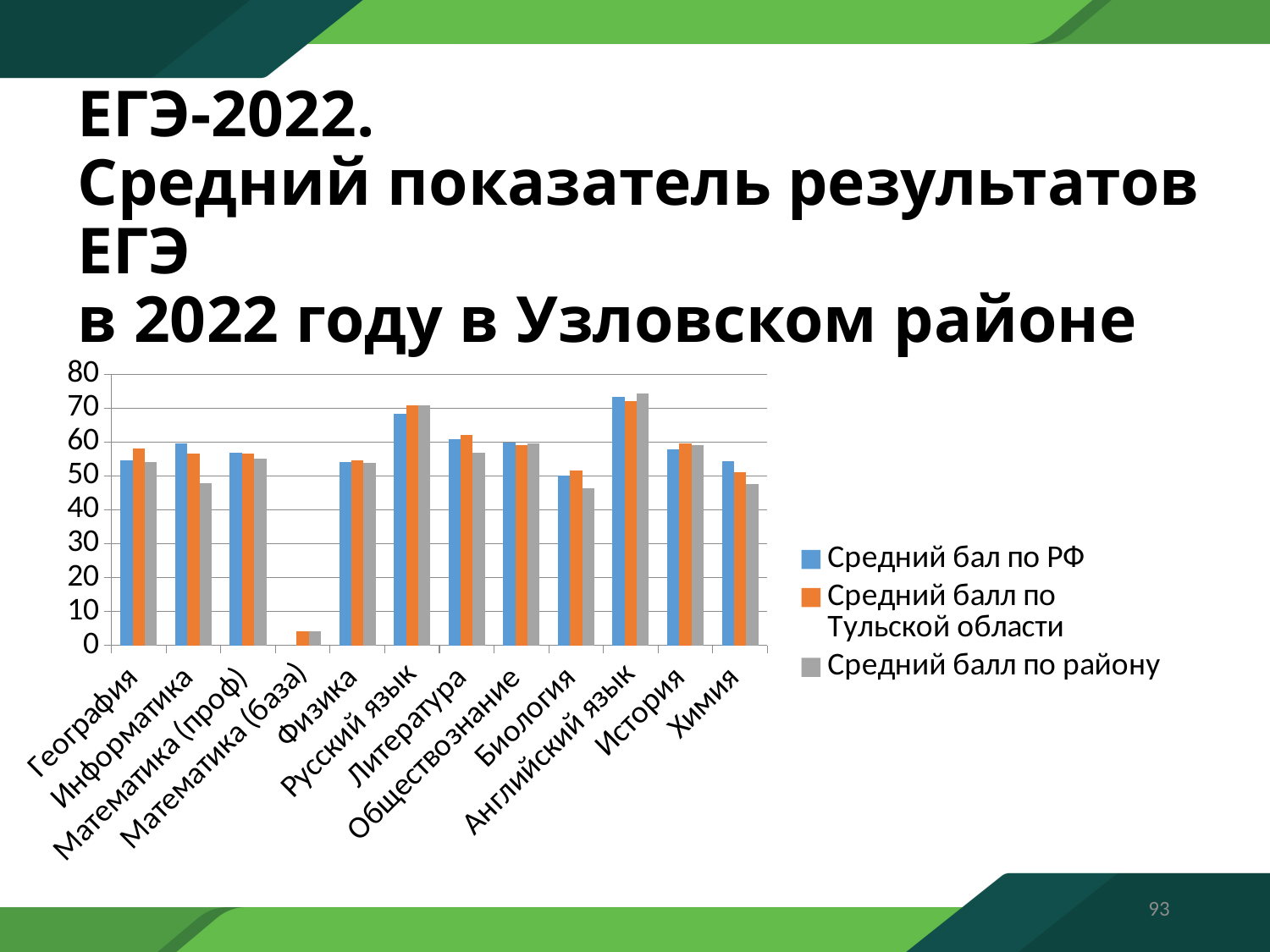
Which colour represents the series 'Средний бал по РФ' in the chart? blue What kind of chart is shown on the slide? bar chart Which subject has the highest value for the series 'Средний балл по району'? Английский язык Is the value for Русский язык in the series 'Средний бал по РФ' greater or less than 60? greater How many subject categories are shown on the x axis of the chart? 12 Is the value for Английский язык in the series 'Средний балл по району' greater or less than 70? greater Which subject has the highest value for the series 'Средний бал по РФ'? Английский язык How many series does the chart legend list? 3 In the series 'Средний бал по РФ', which is larger: the value for Русский язык or for Физика? Русский язык Is the value for Математика (база) in the series 'Средний балл по Тульской области' greater or less than 10? less For Информатика, which is larger: the value for 'Средний бал по РФ' or for 'Средний балл по району'? Средний бал по РФ